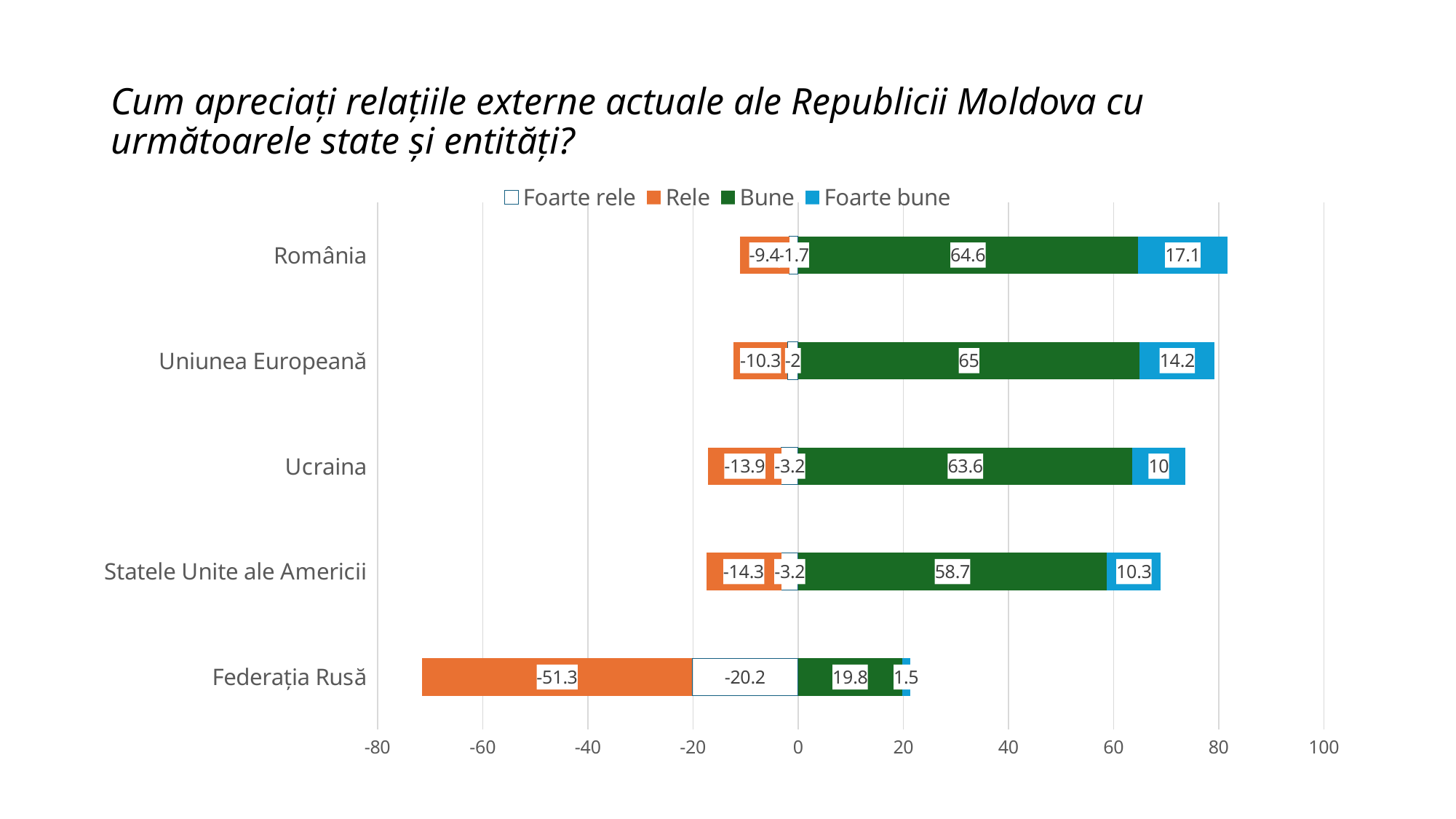
What is the value of the "Foarte rele" series for Statele Unite ale Americii? -3.2 What is the value of the "Rele" series for Federația Rusă? -51.3 Which is larger, the "Foarte bune" value for Ucraina or for Statele Unite ale Americii? Statele Unite ale Americii What kind of chart is shown on the slide? Stacked bar chart Which category has the highest "Foarte bune" value? România How many categories are shown on the chart? 5 What is the difference between the "Bune" values for Uniunea Europeană and Statele Unite ale Americii? 6.3 Which colour represents the "Bune" series in the legend? Dark green What is the value of the "Foarte bune" series for Uniunea Europeană? 14.2 How many series does the legend list? 4 Which category has the lowest "Bune" value? Federația Rusă What is the value of the "Bune" series for România? 64.6